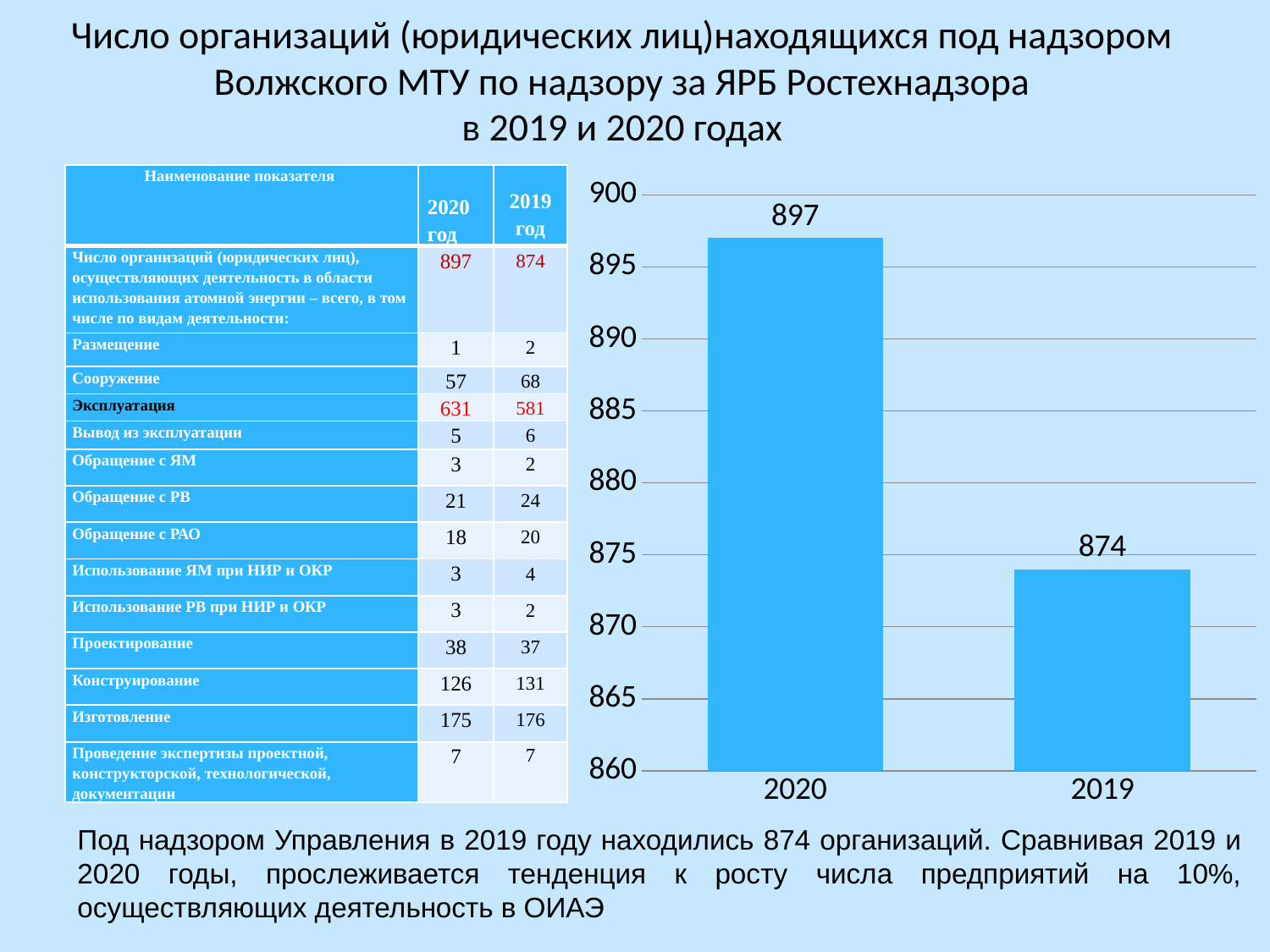
Is the value for 2020 larger or smaller than the value for 2019 in the bar chart? larger What is the value shown for 2019 in the bar chart? 874 Which year has the higher bar in the chart? 2020 What is the difference between the 2020 and 2019 values in the bar chart? 23 Is the value for 2019 greater or less than 880? less What is the highest value labelled on the vertical axis of the chart? 900 What is the value shown for 2020 in the bar chart? 897 Which year has the lower bar in the chart? 2019 What kind of chart is shown on the slide? bar chart Do the values fall or rise from the left bar (2020) to the right bar (2019)? fall How many bars are plotted in the chart? 2 Is the value for 2020 greater or less than 890? greater